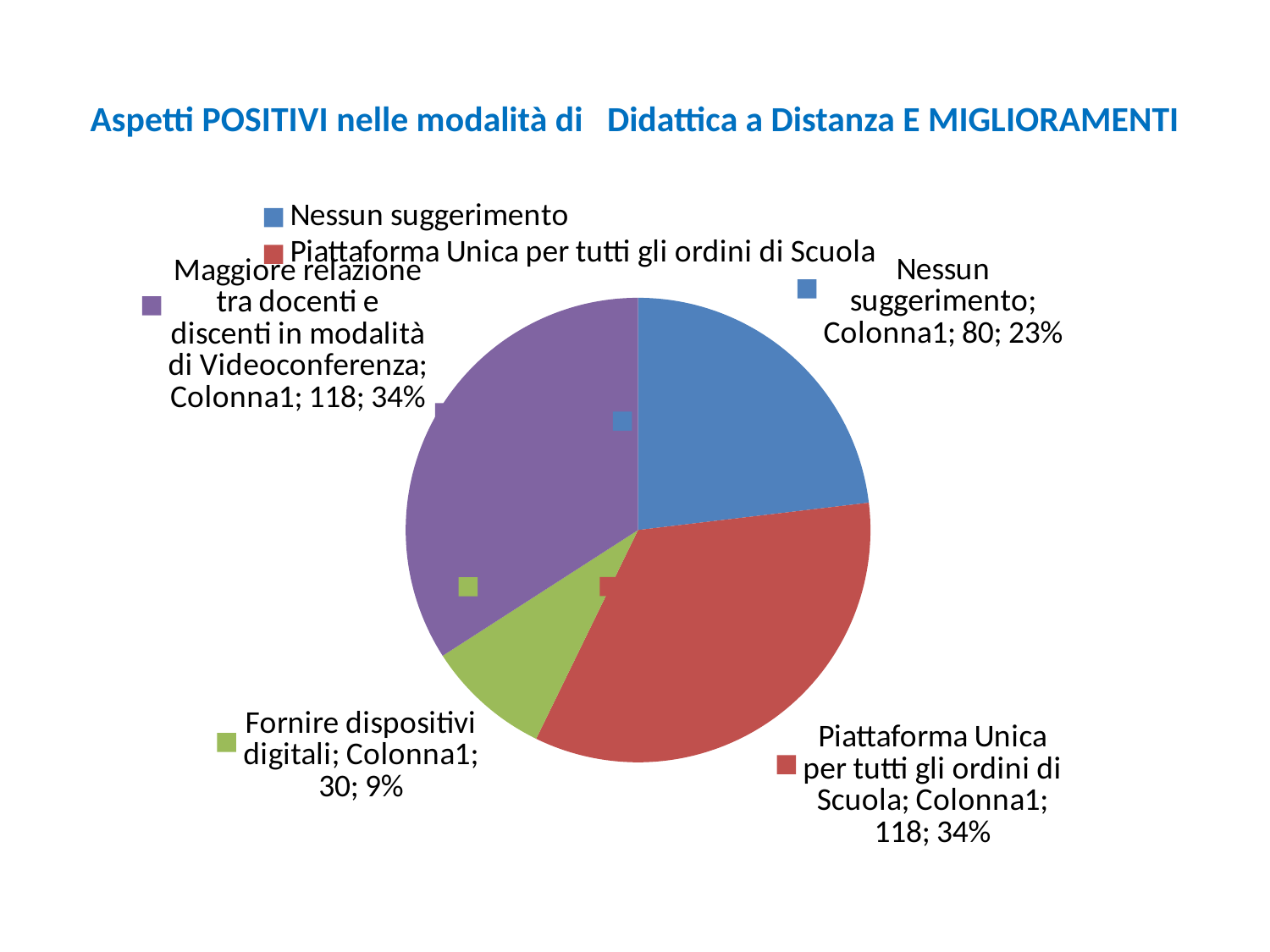
How many slices does the pie chart have? 4 What kind of chart is shown on the slide? pie chart What percentage share does "Nessun suggerimento" have? 23% What percentage share does "Maggiore relazione tra docenti e discenti in modalità di Videoconferenza" have? 34% Which is larger, the value for "Nessun suggerimento" or the value for "Fornire dispositivi digitali"? Nessun suggerimento What is the value for "Fornire dispositivi digitali"? 30 What percentage share does "Fornire dispositivi digitali" have? 9% What is the title of the slide? Aspetti POSITIVI nelle modalità di Didattica a Distanza E MIGLIORAMENTI What is the difference between the values for "Piattaforma Unica per tutti gli ordini di Scuola" and "Nessun suggerimento"? 38 Which category has the smallest slice? Fornire dispositivi digitali What is the value for "Piattaforma Unica per tutti gli ordini di Scuola"? 118 What is the value for "Nessun suggerimento"? 80